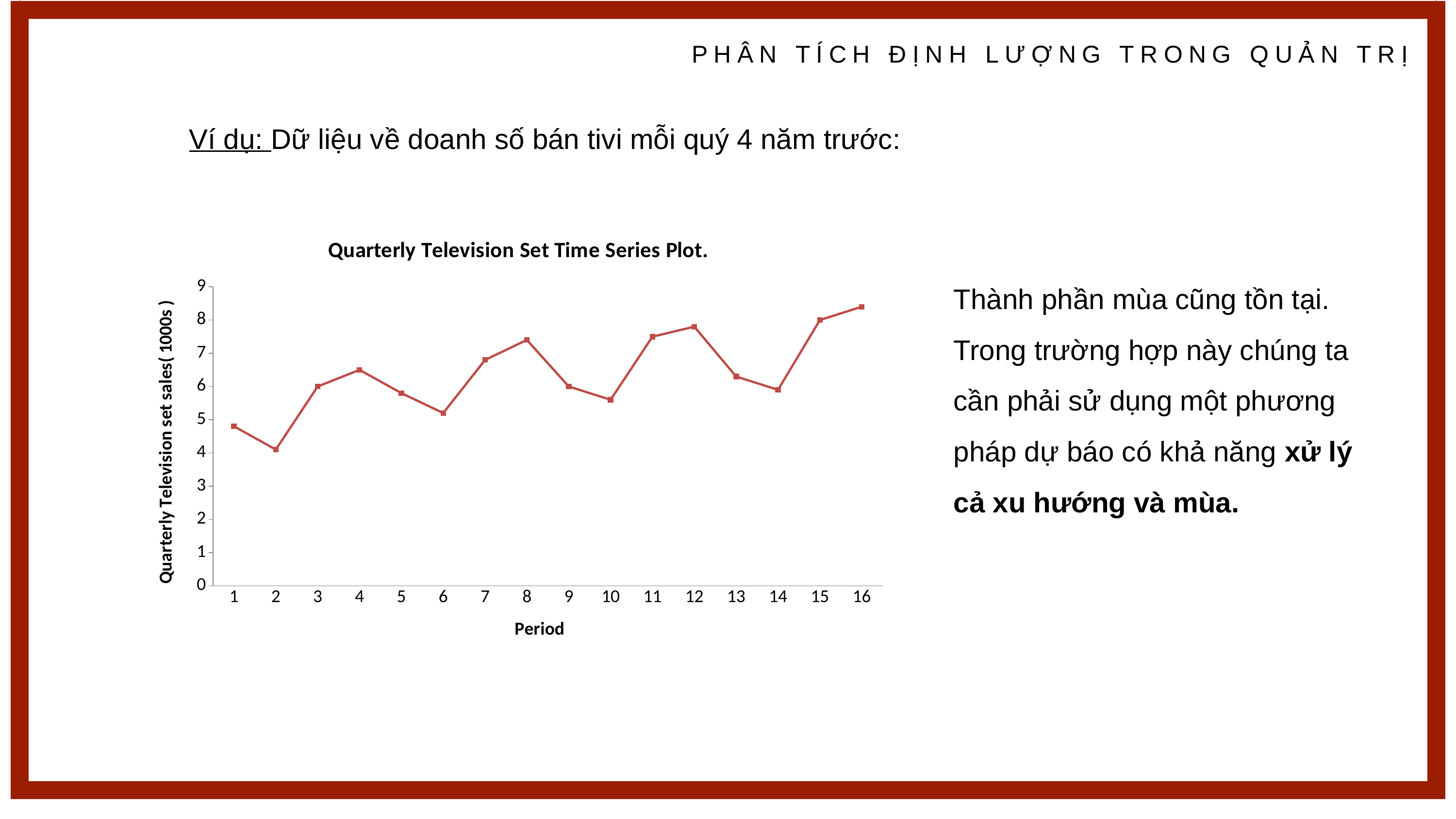
What is the title of the chart? Quarterly Television Set Time Series Plot. How many periods are plotted on the x axis of the chart? 16 Which period has the larger value, period 12 or period 14? 12 Is the value for period 2 greater or less than 5? less Which period has the highest quarterly television set sales? 16 Is the value for period 16 greater or less than 8? greater Is the value for period 8 greater or less than 7? greater What kind of chart is shown on the slide? line chart What is the label of the x axis of the chart? Period Overall, do the quarterly television set sales rise or fall from period 1 to period 16? rise Which period has the lowest quarterly television set sales? 2